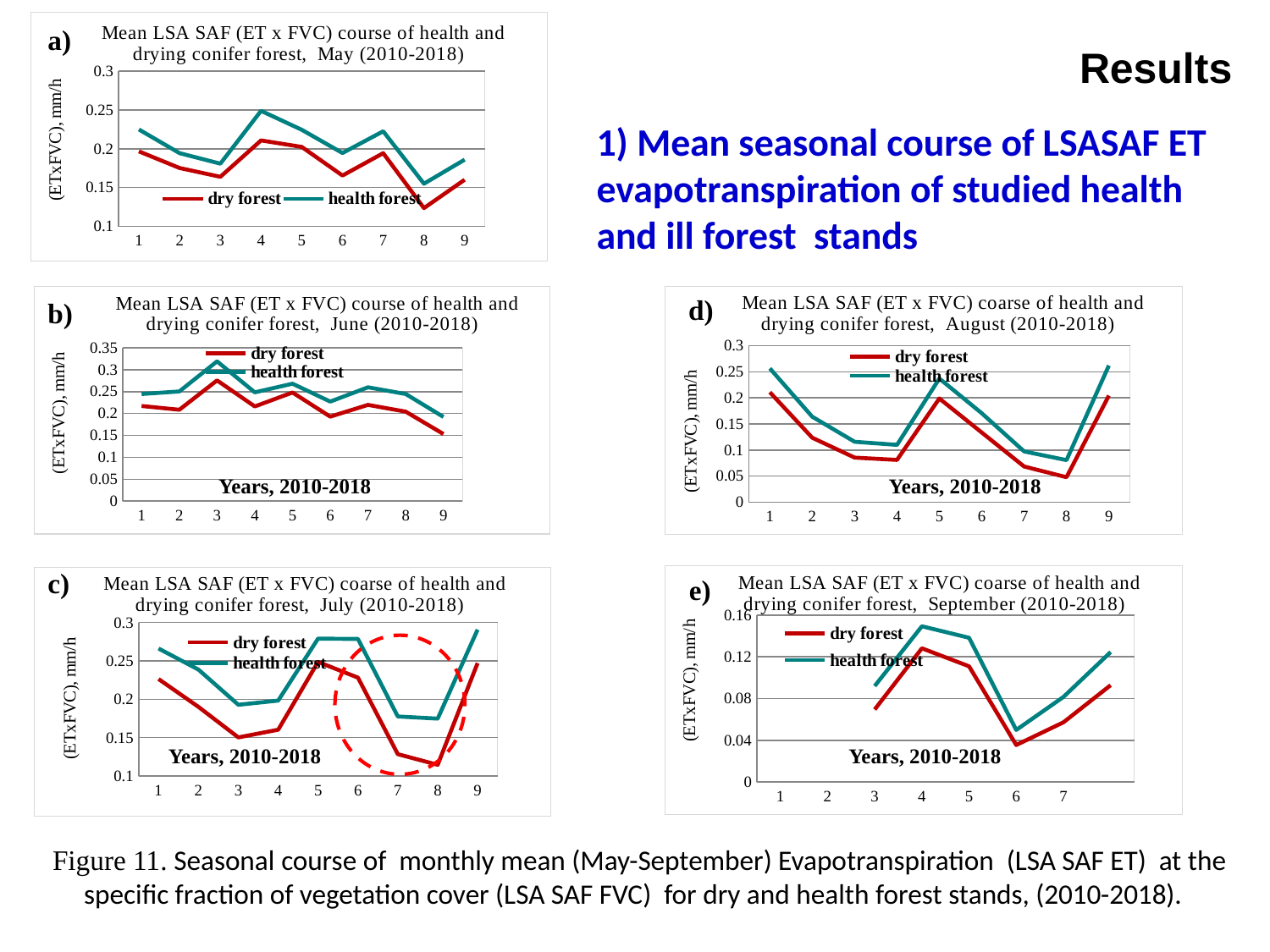
In chart b) (June), at which year does the health forest series reach its highest value? 3 In chart b) (June), is the health forest value at year 3 greater or less than 0.3? greater In chart d) (August), which series has the larger value at year 5, dry forest or health forest? health forest How many series does the legend of chart b) (June) list? 2 In chart c) (July), at which year does the dry forest series reach its lowest value? 8 How many points are plotted along the x axis for each series in chart a) (May)? 9 What is the y-axis label of chart d) (August)? (ETxFVC), mm/h In chart a) (May), is the dry forest value at year 8 greater or less than 0.15? less What kind of chart is chart a) (May)? line chart In chart e) (September), is the health forest value at year 4 greater or less than 0.12? greater In chart d) (August), do the dry forest values rise or fall from year 1 to year 3? fall